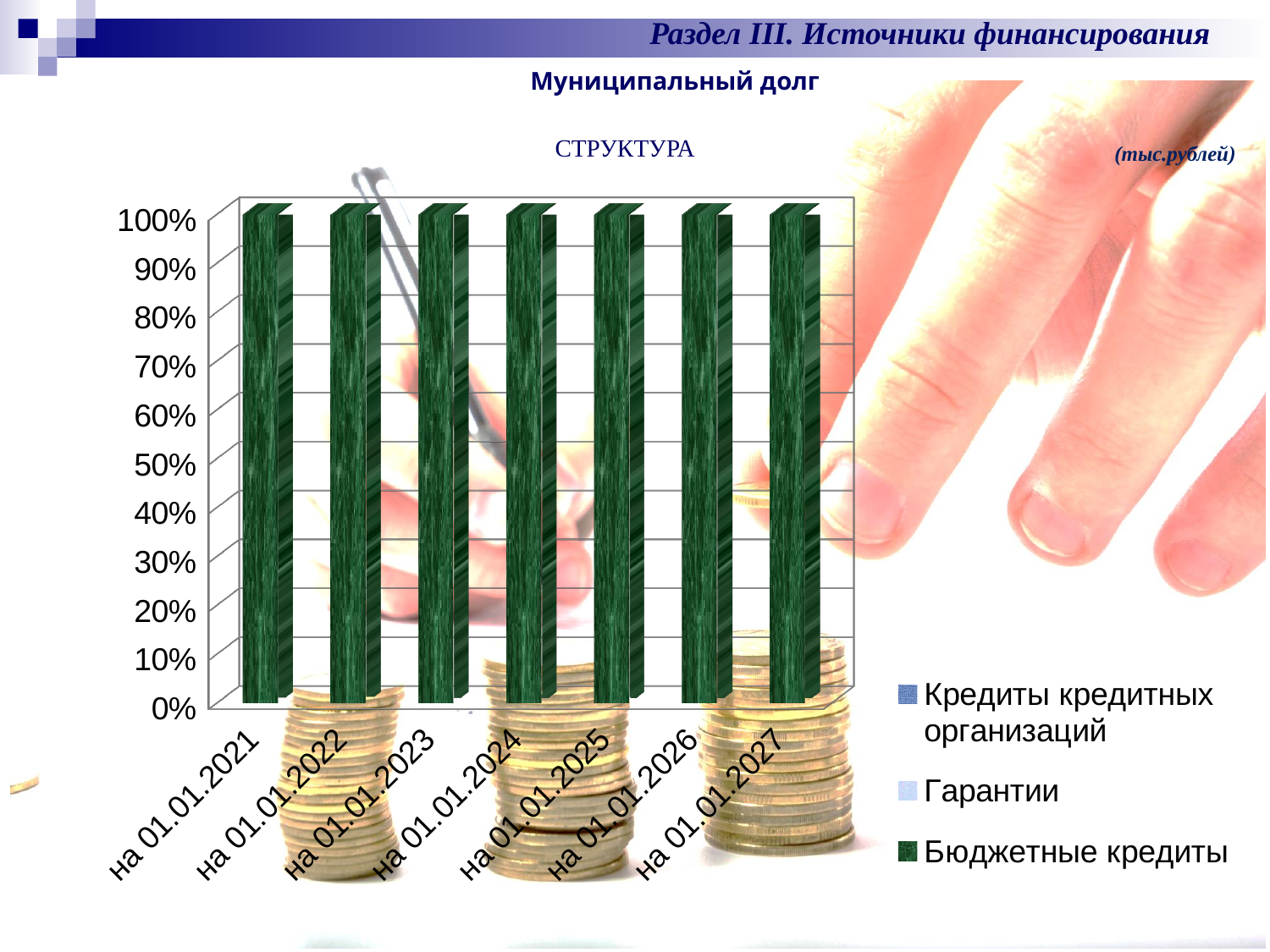
How many series does the chart legend list? 3 What is the highest tick value shown on the vertical axis of the chart? 100% Is the value for Бюджетные кредиты at на 01.01.2024 greater or less than 50%? greater What is the title of the chart? СТРУКТУРА How many categories (dates) are shown on the x axis of the chart? 7 What share does Бюджетные кредиты have in the bar for на 01.01.2027? 100% What share does Бюджетные кредиты have in the bar for на 01.01.2021? 100% What is the first category on the x axis of the chart? на 01.01.2021 What kind of chart is shown on the slide? bar chart Does the share of Бюджетные кредиты rise, fall or stay the same across the dates on the x axis? stays the same Which series is shown in green in the chart legend? Бюджетные кредиты